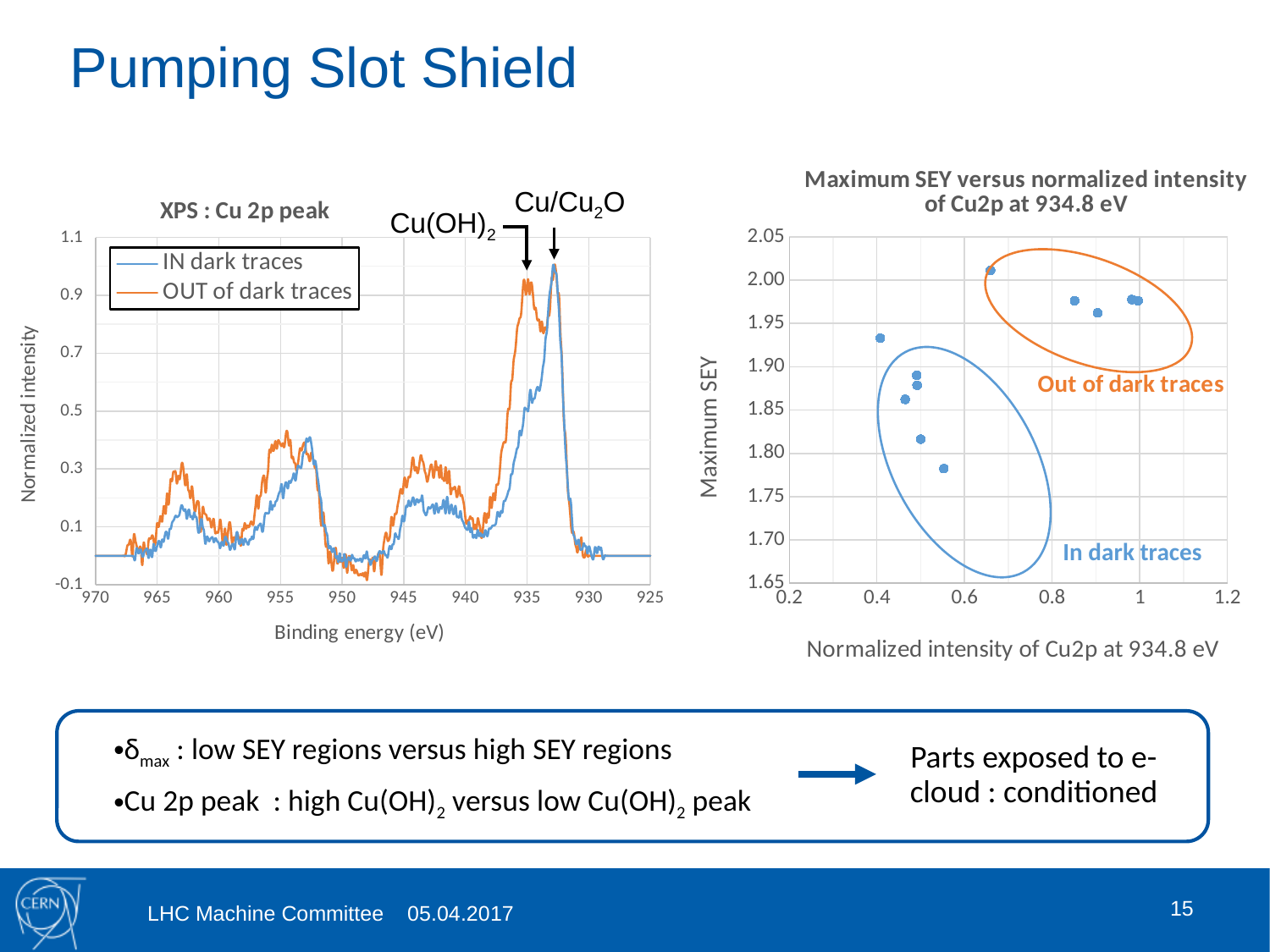
In the 'Maximum SEY versus normalized intensity of Cu2p at 934.8 eV' chart, is the lowest plotted maximum SEY value greater or less than 1.85? less In the 'XPS : Cu 2p peak' chart, is the normalized intensity of the IN dark traces series at about 935 eV greater or less than 0.7? less How many series does the legend of the 'XPS : Cu 2p peak' chart list? 2 What kind of chart is the 'XPS : Cu 2p peak' chart on the left? line chart In the 'Maximum SEY versus normalized intensity of Cu2p at 934.8 eV' chart, is the highest plotted maximum SEY value greater or less than 1.95? greater In the 'XPS : Cu 2p peak' chart, at a binding energy of about 935 eV, which series has the higher normalized intensity, IN dark traces or OUT of dark traces? OUT of dark traces In the 'Maximum SEY versus normalized intensity of Cu2p at 934.8 eV' chart, which group of points has the higher maximum SEY values, 'In dark traces' or 'Out of dark traces'? Out of dark traces In the 'XPS : Cu 2p peak' chart, what are the two series named in the legend? IN dark traces and OUT of dark traces In the 'XPS : Cu 2p peak' chart, at a binding energy of about 963 eV, which series has the higher normalized intensity, IN dark traces or OUT of dark traces? OUT of dark traces In the 'XPS : Cu 2p peak' chart, what is the label of the x axis? Binding energy (eV) What kind of chart is the 'Maximum SEY versus normalized intensity of Cu2p at 934.8 eV' chart on the right? scatter chart